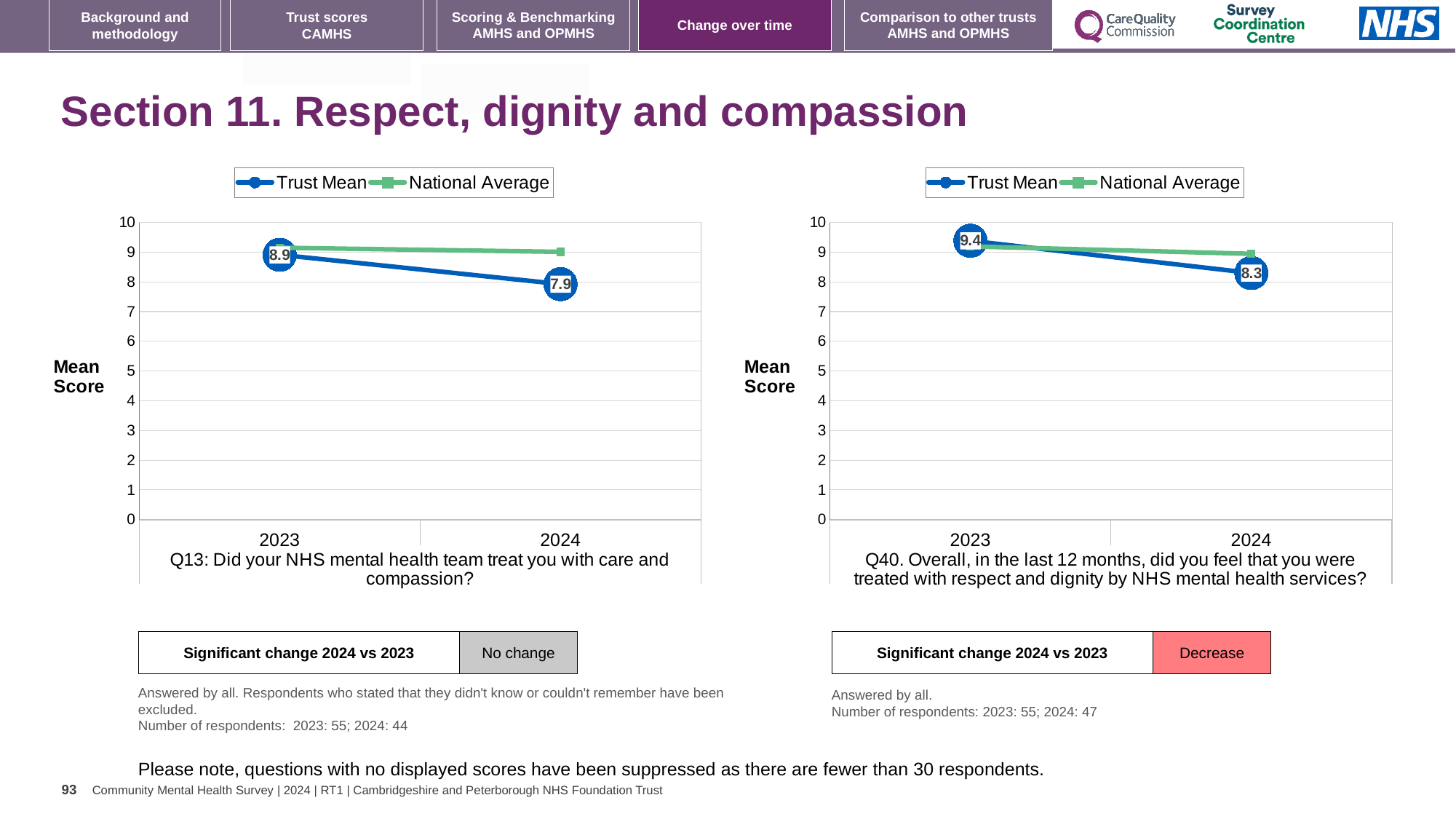
How many series does the legend of the right chart (Q40) list? 2 In the right chart (Q40), what is the Trust Mean value for 2023? 9.4 How many years are shown on the x axis of the left chart (Q13)? 2 In the left chart (Q13), what is the Trust Mean value for 2023? 8.9 In the right chart (Q40), which is larger in 2024: the Trust Mean or the National Average? National Average In the right chart (Q40), what is the Trust Mean value for 2024? 8.3 In the right chart (Q40), does the Trust Mean rise or fall from 2023 to 2024? fall In the left chart (Q13), is the National Average for 2024 greater or less than 8? greater What type of chart is the left chart (Q13)? line chart In the left chart (Q13), what is the Trust Mean value for 2024? 7.9 In the left chart (Q13), by how much did the Trust Mean fall from 2023 to 2024? 1.0 In the right chart (Q40), what is the difference between the Trust Mean in 2023 and 2024? 1.1